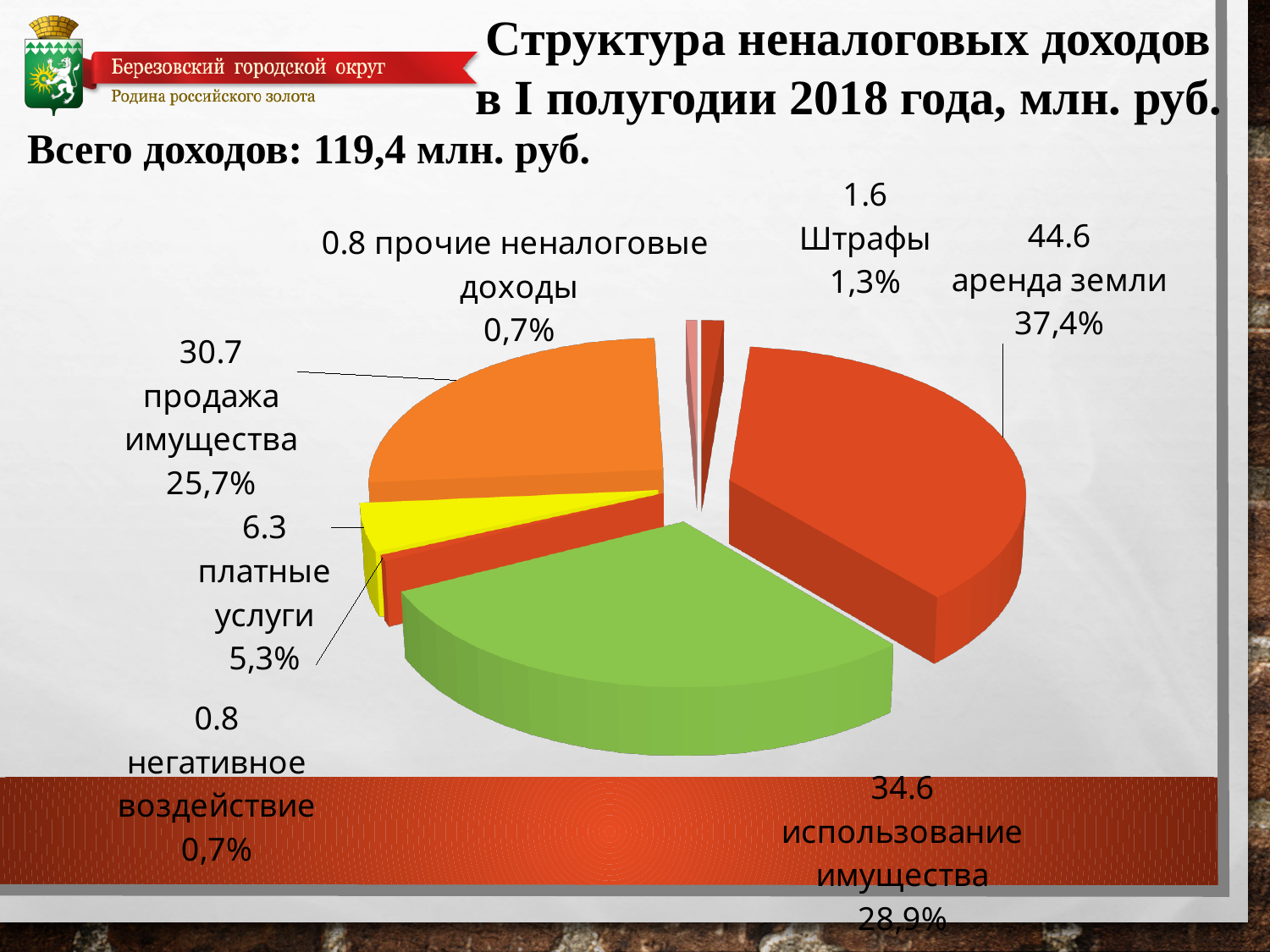
What is the difference between the values for аренда земли and использование имущества? 10 What is the value for аренда земли? 44.6 What share of the pie does платные услуги have? 5,3% Which category has the largest slice of the pie? аренда земли What is the value for продажа имущества? 30.7 What share of the pie does использование имущества have? 28,9% What kind of chart is shown on the slide? pie chart Which is larger, продажа имущества or использование имущества? использование имущества What is the value for Штрафы? 1.6 How many categories are shown in the pie chart? 7 What share of the pie does негативное воздействие have? 0,7% What total income amount is stated on the slide? 119,4 млн. руб.